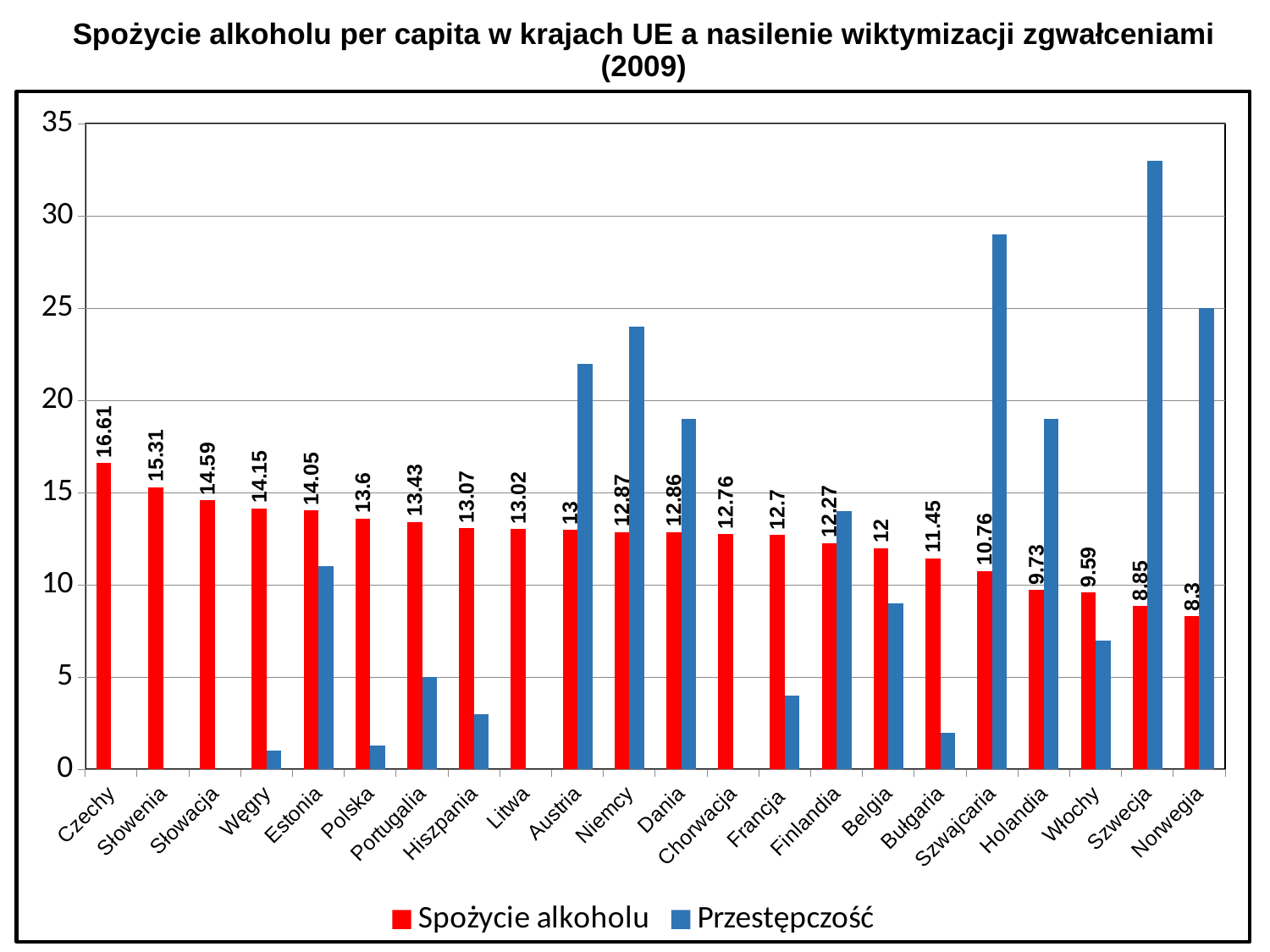
What is the Spożycie alkoholu value for Czechy? 16.61 Which has a larger Spożycie alkoholu value, Polska or Portugalia? Polska Is the Przestępczość value for Austria greater or less than 20? greater What is the difference between the Spożycie alkoholu values for Czechy and Norwegia? 8.31 Is the Przestępczość value for Szwecja greater or less than 30? greater How many countries are shown on the x axis? 22 Which country has the lowest Spożycie alkoholu value? Norwegia Do the Spożycie alkoholu values rise or fall from left to right along the x axis? fall What is the Spożycie alkoholu value for Norwegia? 8.3 Which country has the highest Spożycie alkoholu value? Czechy Which country has the highest Przestępczość value? Szwecja How many series does the legend list? 2